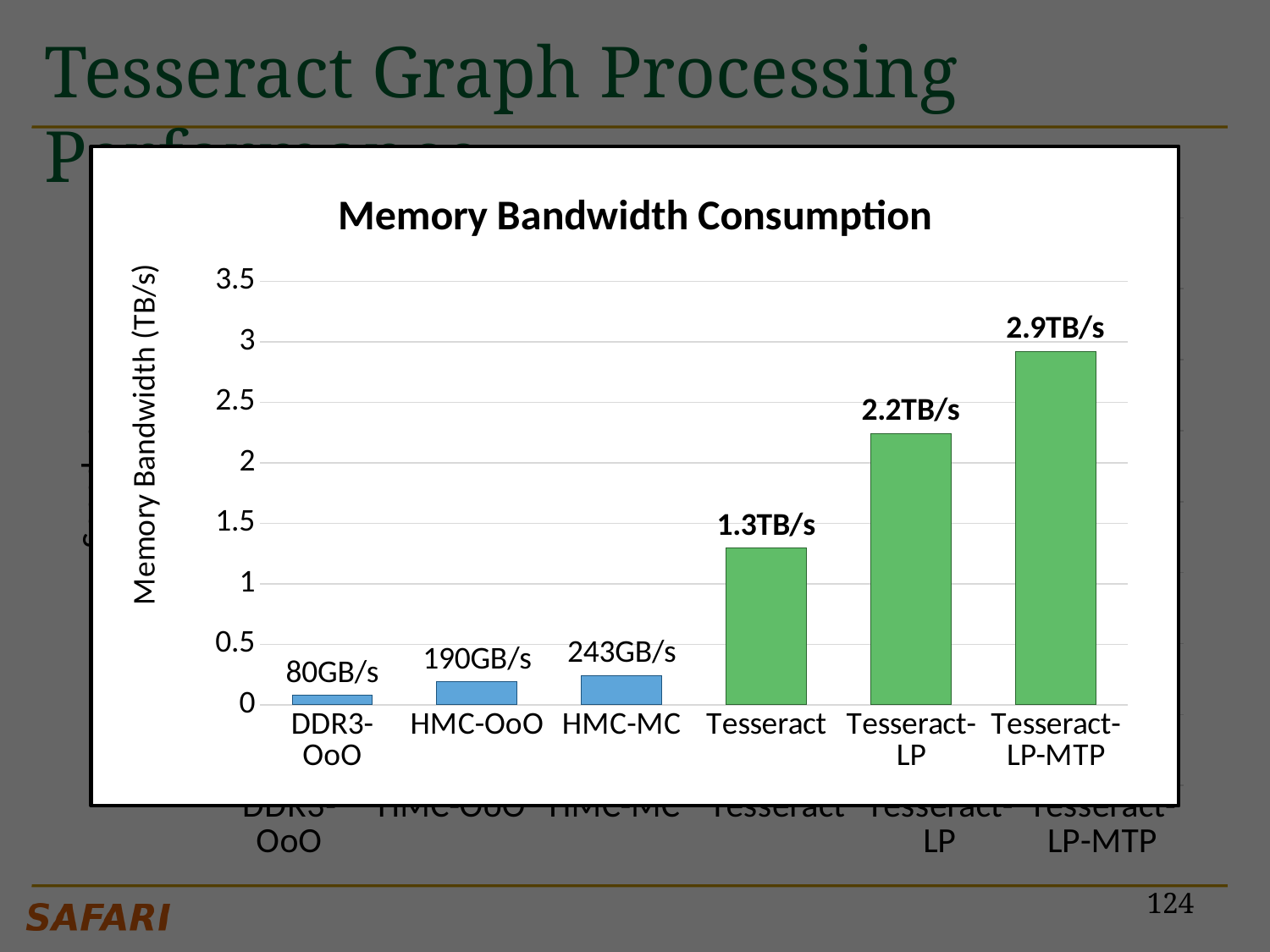
What is the memory bandwidth consumption for Tesseract-LP-MTP? 2.9TB/s Which configuration has the highest memory bandwidth consumption? Tesseract-LP-MTP What is the difference in memory bandwidth consumption between HMC-OoO and DDR3-OoO? 110GB/s Is the value for Tesseract-LP greater or less than 2 TB/s? greater What type of chart is used to show Memory Bandwidth Consumption? Bar chart What is the memory bandwidth consumption for DDR3-OoO? 80GB/s What is the memory bandwidth consumption for Tesseract? 1.3TB/s What is the memory bandwidth consumption for HMC-MC? 243GB/s Which configuration has the lowest memory bandwidth consumption? DDR3-OoO Which has higher memory bandwidth consumption, HMC-MC or Tesseract? Tesseract How many configurations are shown on the x axis of the chart? 6 What is the difference in memory bandwidth consumption between Tesseract-LP-MTP and Tesseract-LP? 0.7TB/s